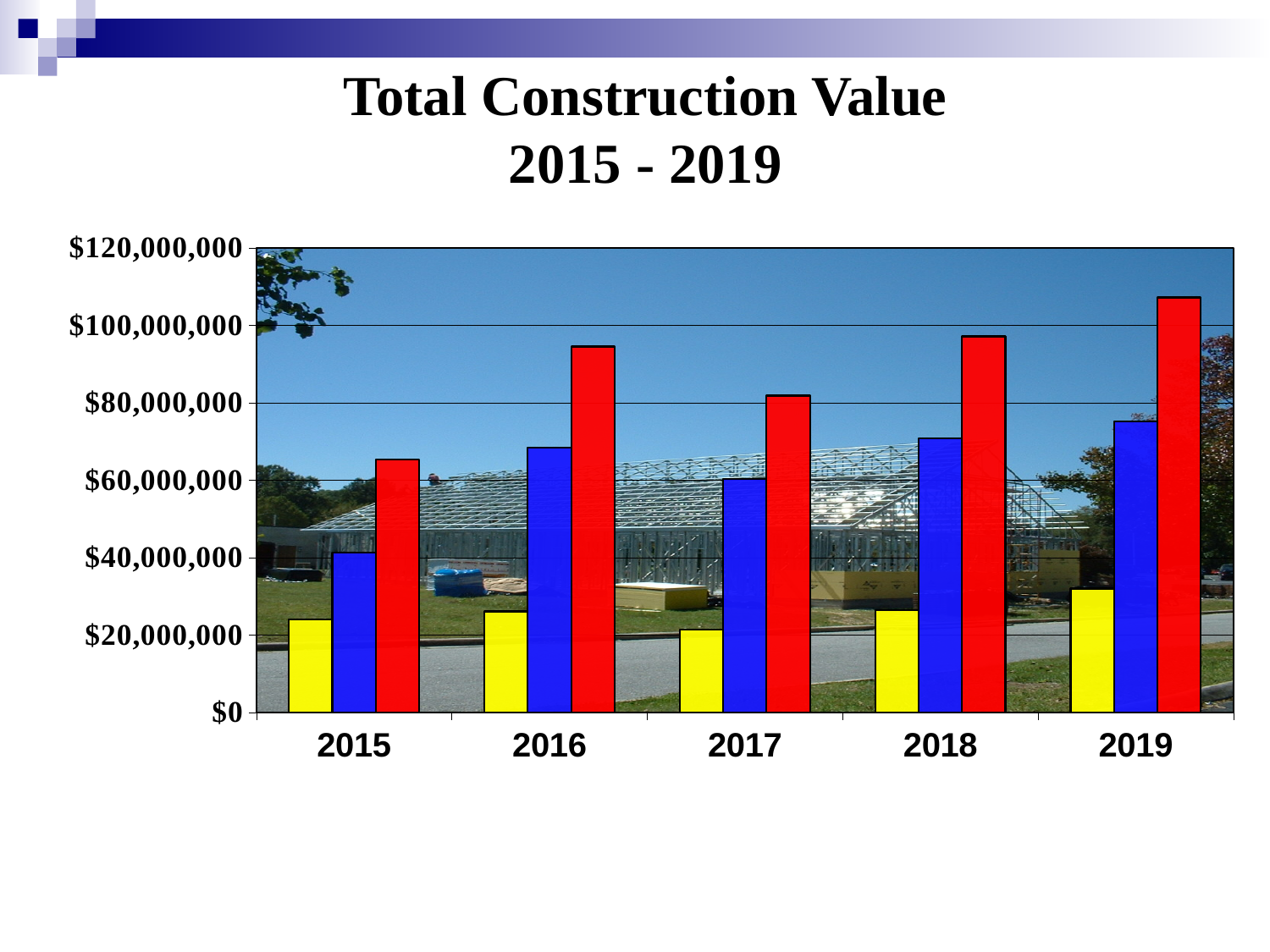
How many years are shown on the x axis of the chart? 5 Is the value of the yellow bar for 2017 greater or less than $40,000,000? less Is the value of the red bar for 2019 greater or less than $100,000,000? greater How many bars are plotted for each year in the chart? 3 Which year has the tallest red bar? 2019 What is the title of the chart? Total Construction Value 2015 - 2019 Is the value of the red bar for 2015 greater or less than $80,000,000? less Which year has the shortest blue bar? 2015 What kind of chart is shown on the slide? bar chart Which year has the shortest red bar? 2015 Which is larger, the red bar for 2016 or the red bar for 2017? 2016